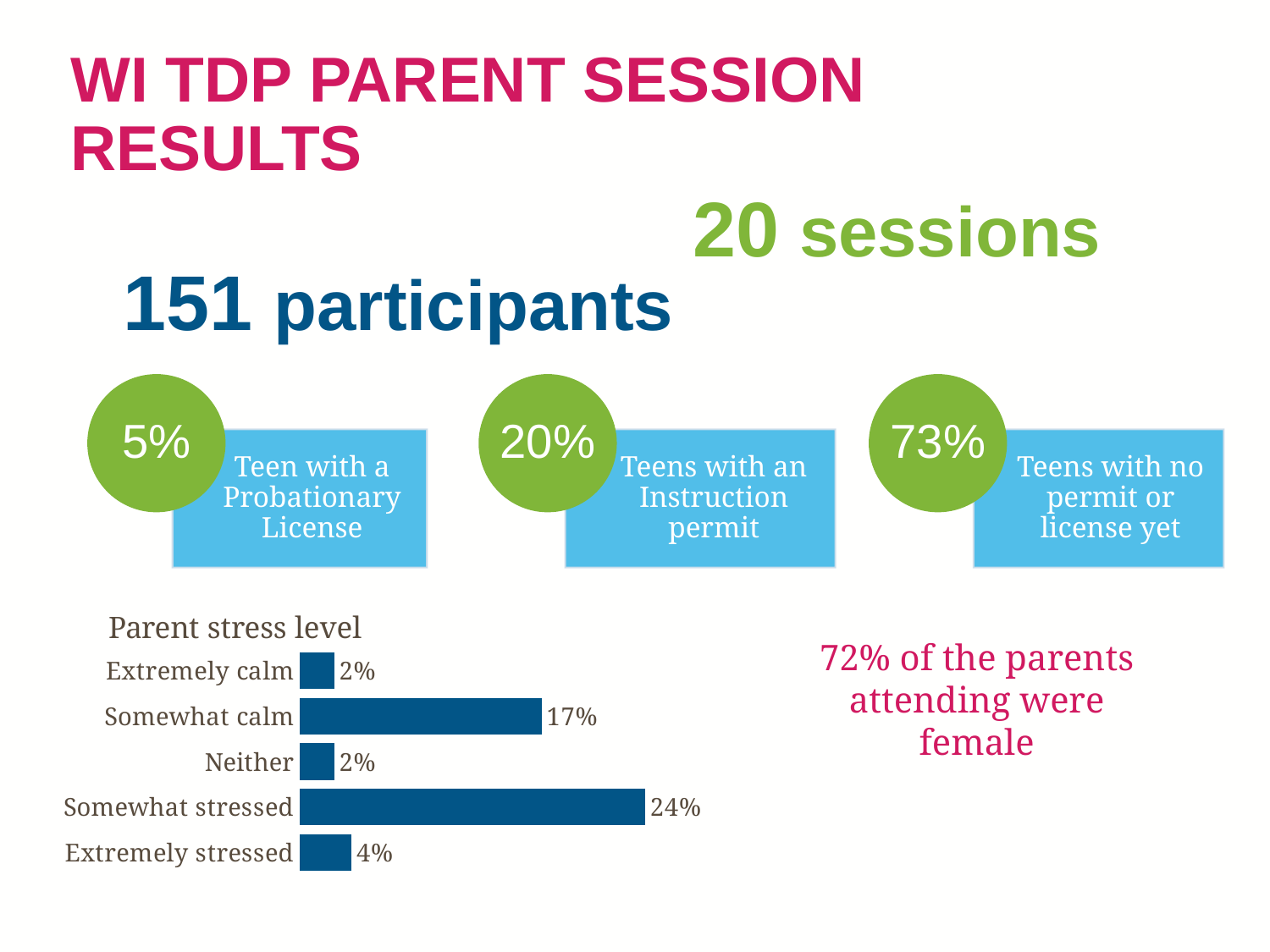
What kind of chart is the Parent stress level chart? Bar chart What is the value for Neither in the Parent stress level chart? 2% What is the value for Somewhat calm in the Parent stress level chart? 17% What is the difference between Somewhat calm and Extremely calm in the Parent stress level chart? 15% What is the value for Somewhat stressed in the Parent stress level chart? 24% How many categories are shown in the Parent stress level chart? 5 What colour are the bars in the Parent stress level chart? Dark blue What is the difference between Somewhat stressed and Somewhat calm in the Parent stress level chart? 7% Which is larger in the Parent stress level chart, Extremely stressed or Extremely calm? Extremely stressed What is the title of the bar chart on the slide? Parent stress level Which category has the highest value in the Parent stress level chart? Somewhat stressed What is the value for Extremely stressed in the Parent stress level chart? 4%